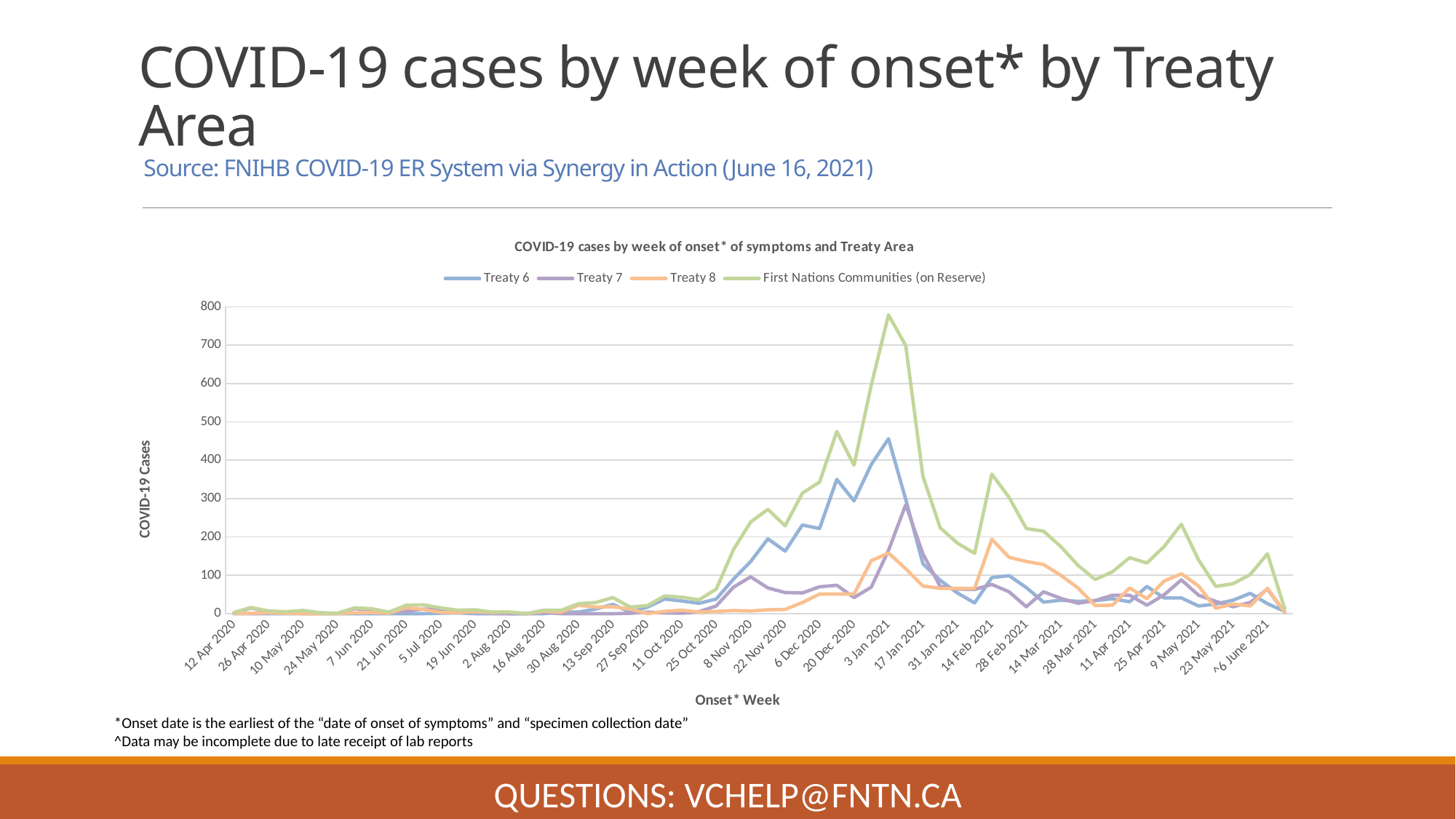
Which series is drawn with the green line? First Nations Communities (on Reserve) Is the peak value for Treaty 7 in January 2021 greater or less than 200? greater What is the title of the chart's vertical axis? COVID-19 Cases What kind of chart is shown on the slide? Line chart Which series has the lowest peak value on the chart? Treaty 8 At 3 Jan 2021, which series has the larger value: Treaty 6 or Treaty 8? Treaty 6 Is the peak value for First Nations Communities (on Reserve) around 3 Jan 2021 greater or less than 700? greater How many series does the chart's legend list? 4 Is the peak value for Treaty 6 around 3 Jan 2021 greater or less than 400? greater Does the First Nations Communities (on Reserve) line generally rise or fall between 25 Oct 2020 and 3 Jan 2021? Rise Which series reaches the highest peak on the chart? First Nations Communities (on Reserve)